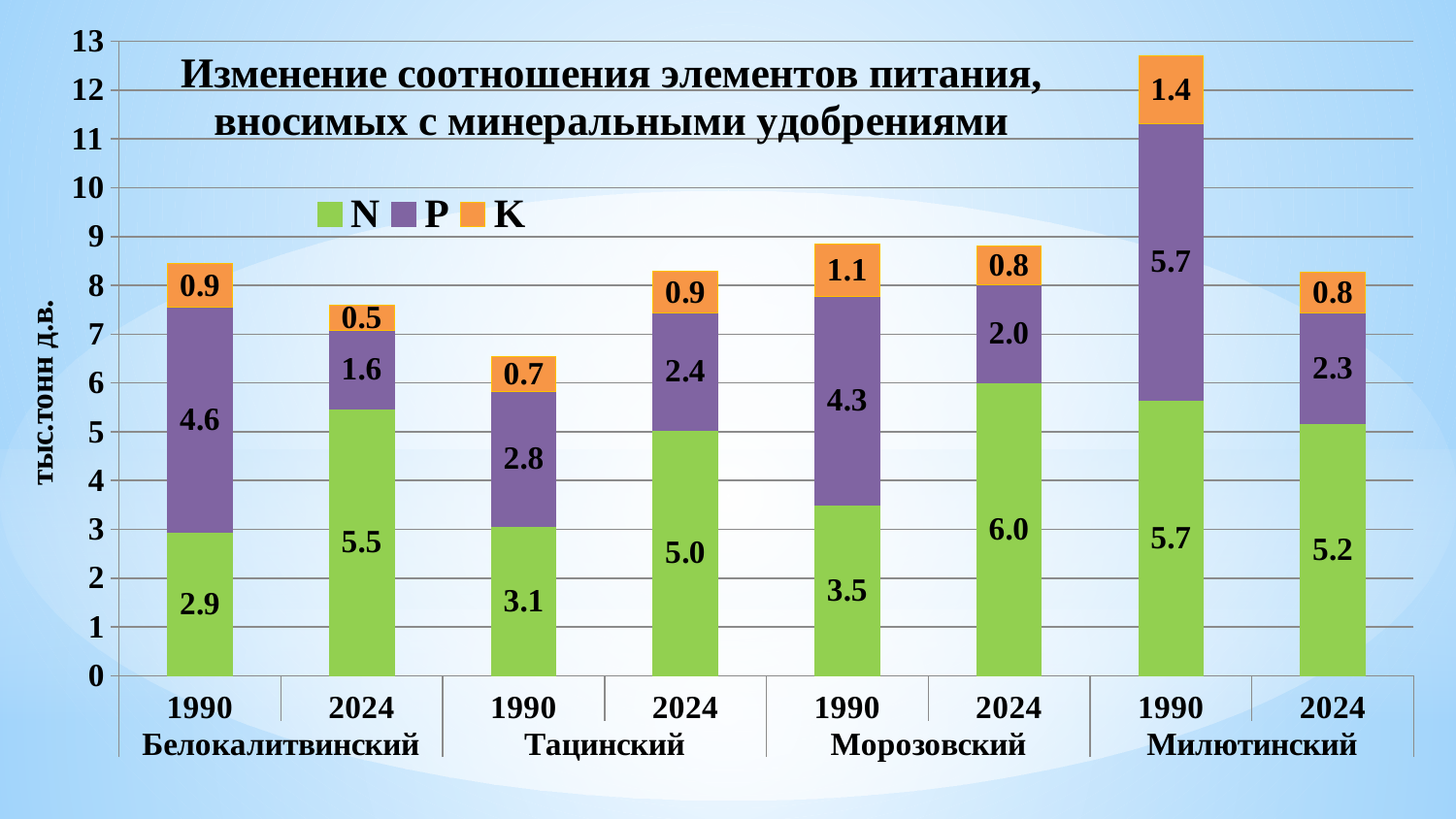
How many series does the legend list? 3 What is the N value for Милютинский in 1990? 5.7 What is the total of the stacked bar for Милютинский in 1990? 12.8 What is the P value for Белокалитвинский in 1990? 4.6 What is the difference between the P value for Морозовский in 1990 and in 2024? 2.3 What is the K value for Морозовский in 2024? 0.8 Which is larger: the N value for Тацинский in 2024 or the N value for Морозовский in 2024? Морозовский 2024 Which bar has the highest total? Милютинский 1990 How many bars are shown in the chart? 8 What type of chart is shown? Stacked bar chart Which district and year has the lowest N value? Белокалитвинский 1990 What is the total of the stacked bar for Тацинский in 2024? 8.3